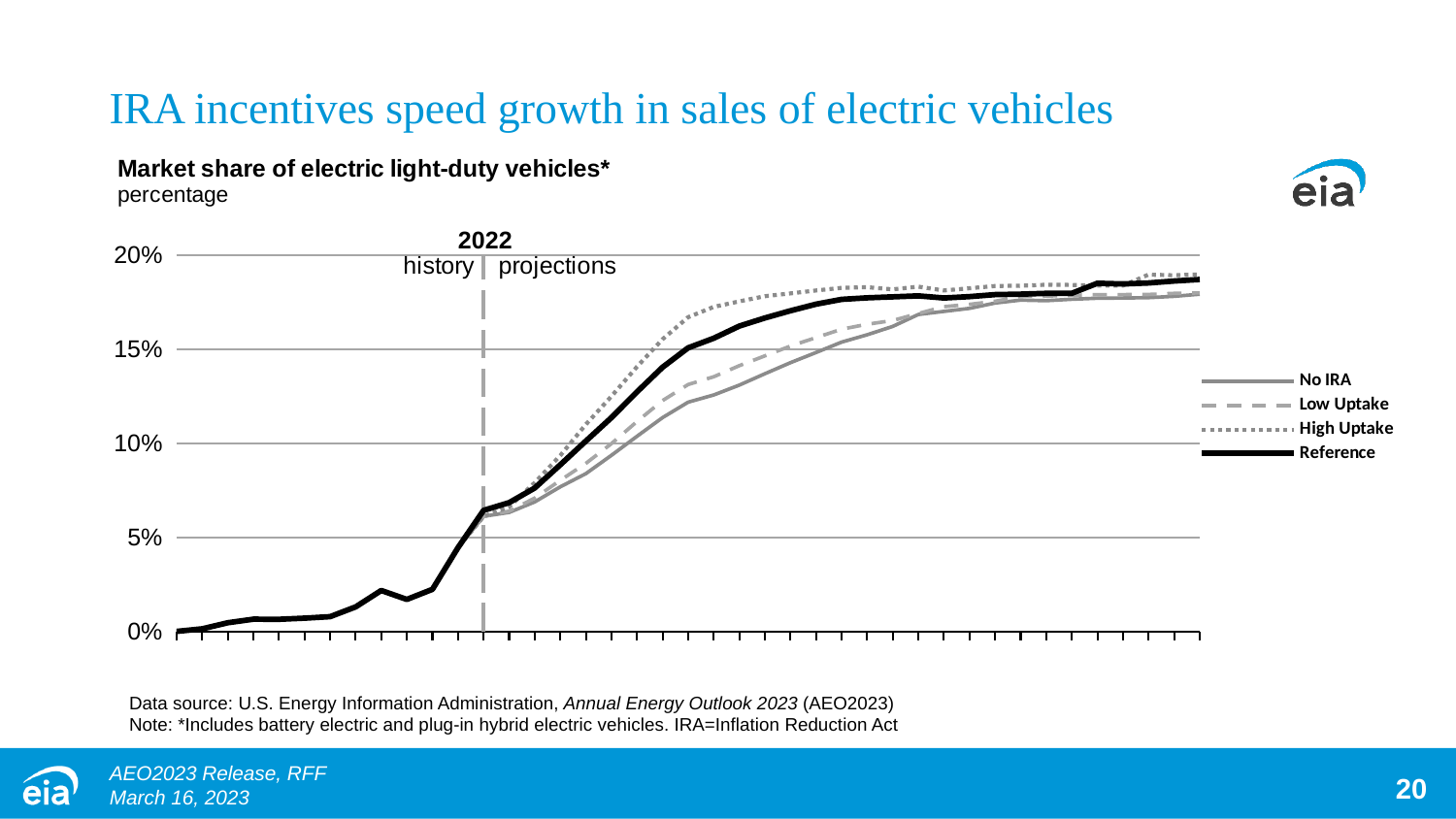
In the middle of the projection period, which is larger: the Reference series or the No IRA series? Reference Which series has the lowest market share in the middle of the projection period? No IRA Which series reaches the highest market share during the projection period? High Uptake How many series does the legend list? 4 Is the market share at the 2022 dividing line greater or less than 5%? greater Does the market share of electric light-duty vehicles rise or fall over the projection period? rise Is the market share at the start of the history period greater or less than 5%? less What is the title of the chart? Market share of electric light-duty vehicles* Which year separates history from projections on the chart? 2022 What kind of chart is shown on the slide? line chart Is the High Uptake series value at the end of the projection period greater or less than 20%? less